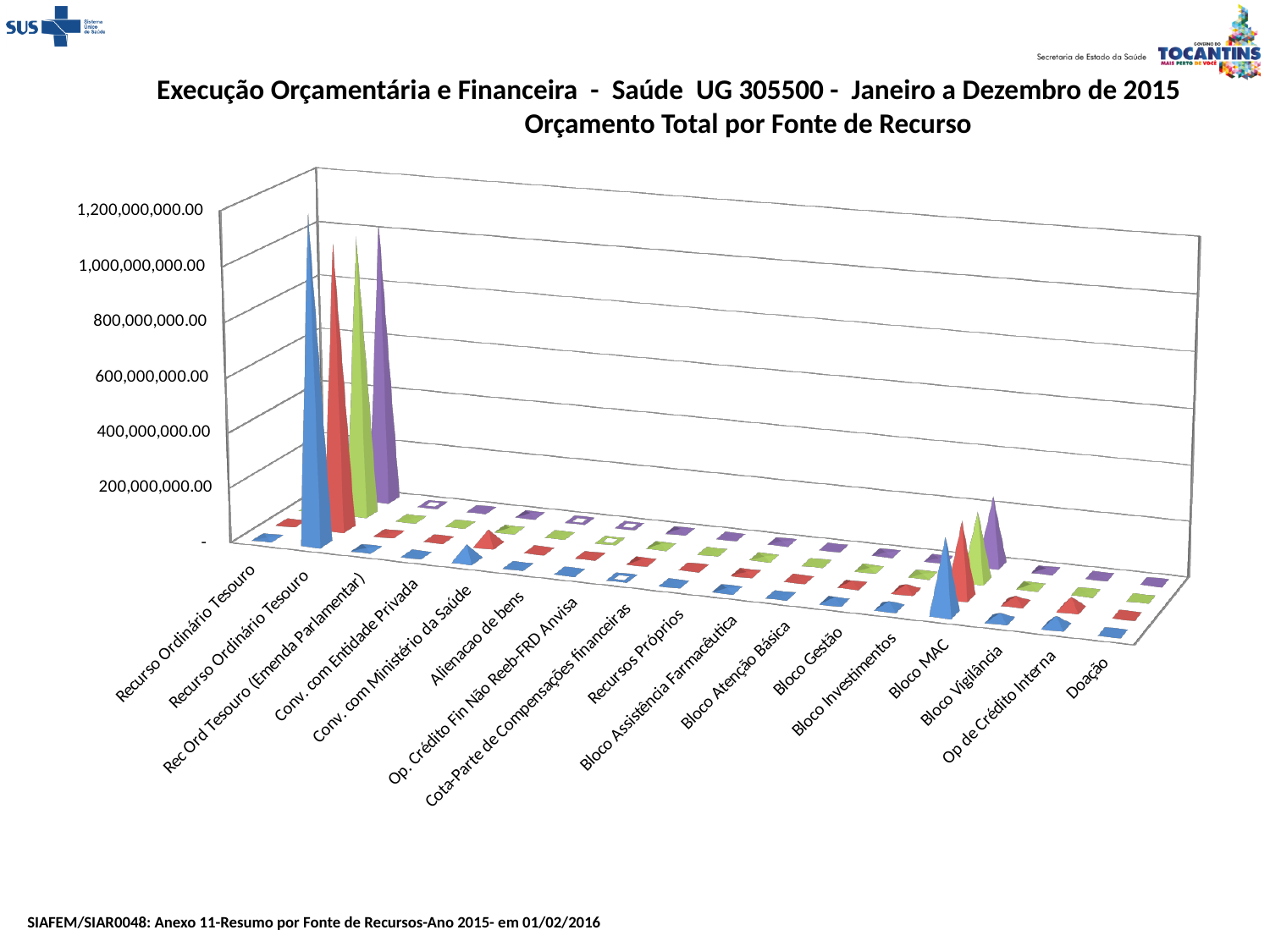
Which has larger values, the second Recurso Ordinário Tesouro category or Bloco Investimentos? Recurso Ordinário Tesouro Which has larger values, Bloco MAC or Bloco Gestão? Bloco MAC What is the second line of the chart's title? Orçamento Total por Fonte de Recurso Which has larger values, Bloco MAC or Bloco Vigilância? Bloco MAC Which category has the tallest bars in the chart? Recurso Ordinário Tesouro (the second category) Is the value for Doação greater or less than 200,000,000.00? less Is the tallest blue bar for the second Recurso Ordinário Tesouro category greater or less than 800,000,000.00? greater What is the highest value labelled on the vertical axis of the chart? 1,200,000,000.00 How many categories are shown along the x axis of the chart? 17 What kind of chart is shown on the slide? bar chart Is the value for Bloco Gestão greater or less than 200,000,000.00? less